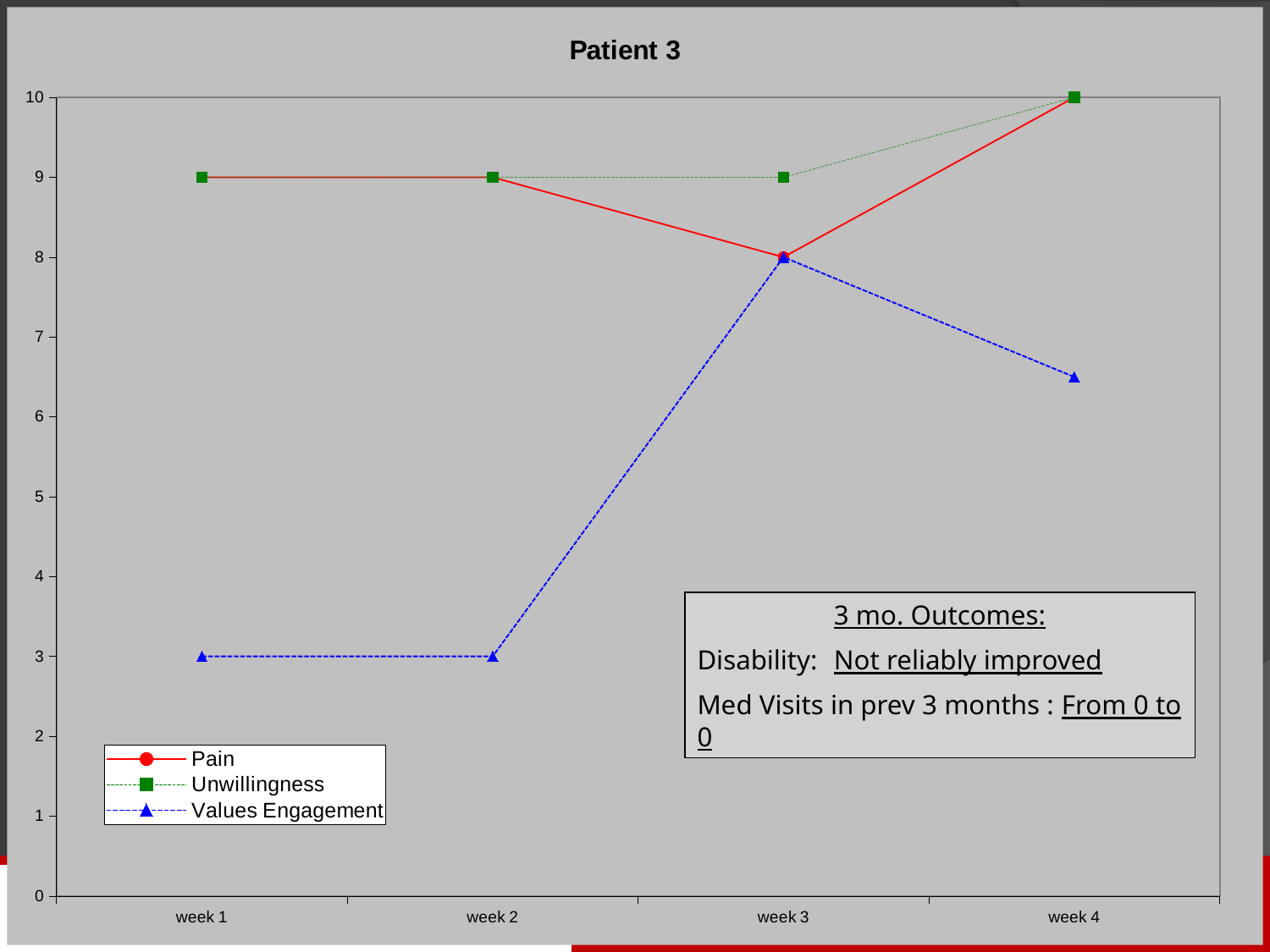
Is the Values Engagement value at week 4 greater or less than 7? less How many weeks are shown on the x axis? 4 What is the Pain value at week 4? 10 What is the difference between the Pain value at week 4 and at week 3? 2 What is the title of the chart? Patient 3 In which week is Pain at its lowest? week 3 What is the Values Engagement value at week 1? 3 Does Values Engagement rise or fall from week 2 to week 3? rise How many series does the legend list? 3 What kind of chart is shown on the slide? line chart What is the Pain value at week 3? 8 At week 2, which is larger: Pain or Values Engagement? Pain